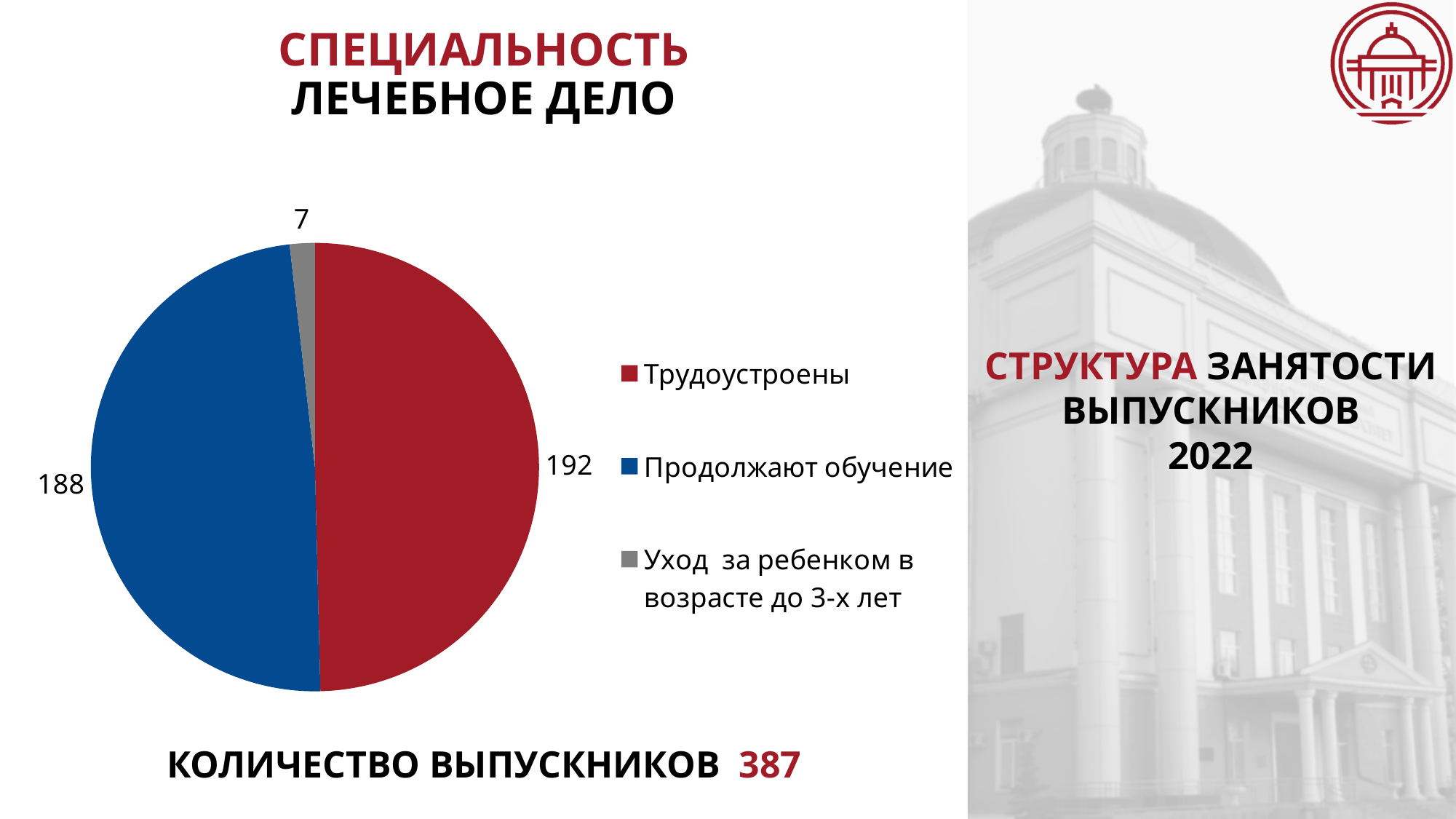
How many graduates are in the "Трудоустроены" category? 192 What type of chart is shown on the slide? Pie chart What is the value for "Продолжают обучение"? 188 Which category has the largest slice of the pie? Трудоустроены What is the difference between the "Трудоустроены" and "Продолжают обучение" values? 4 How many categories does the pie chart have? 3 What is the value for "Уход за ребенком в возрасте до 3-х лет"? 7 What colour is the "Продолжают обучение" slice? Blue What is the total number of graduates shown on the slide? 387 Which category has the smallest slice of the pie? Уход за ребенком в возрасте до 3-х лет Which is larger: "Продолжают обучение" or "Уход за ребенком в возрасте до 3-х лет"? Продолжают обучение How many entries does the legend list? 3